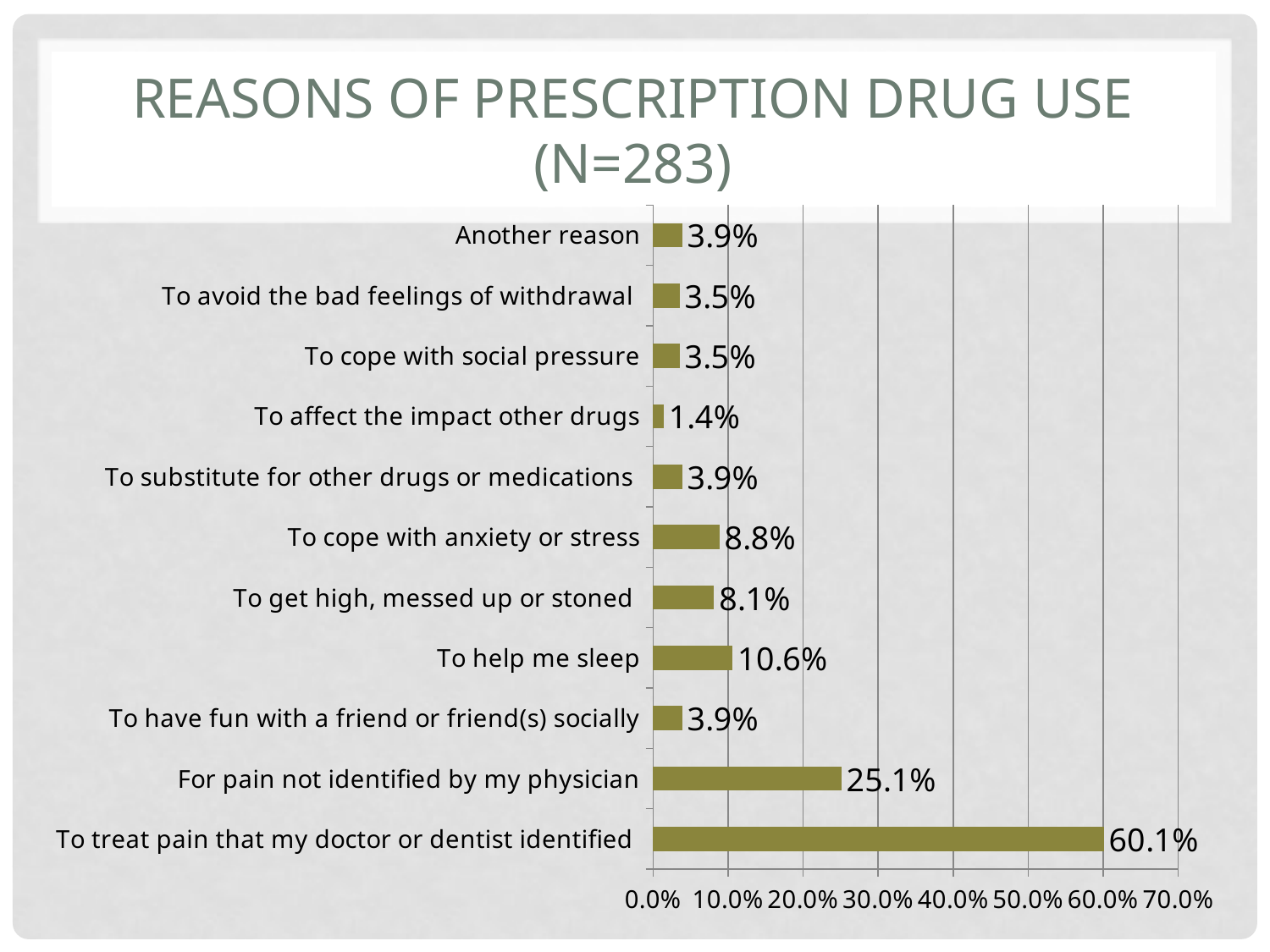
What is the difference between 'To help me sleep' and 'To get high, messed up or stoned'? 2.5% Which is larger: 'To cope with anxiety or stress' or 'To get high, messed up or stoned'? To cope with anxiety or stress What is the value for 'For pain not identified by my physician'? 25.1% Which reason has the highest percentage? To treat pain that my doctor or dentist identified Is the value for 'To treat pain that my doctor or dentist identified' greater or less than 50.0%? greater What percentage of respondents reported using prescription drugs to help them sleep? 10.6% What sample size (N) is given in the chart title? 283 How many reasons (categories) are shown in the chart? 11 What percentage reported using prescription drugs to cope with anxiety or stress? 8.8% What is the difference between 'To treat pain that my doctor or dentist identified' and 'For pain not identified by my physician'? 35.0% Which reason has the lowest percentage? To affect the impact other drugs What kind of chart is shown on the slide? Bar chart